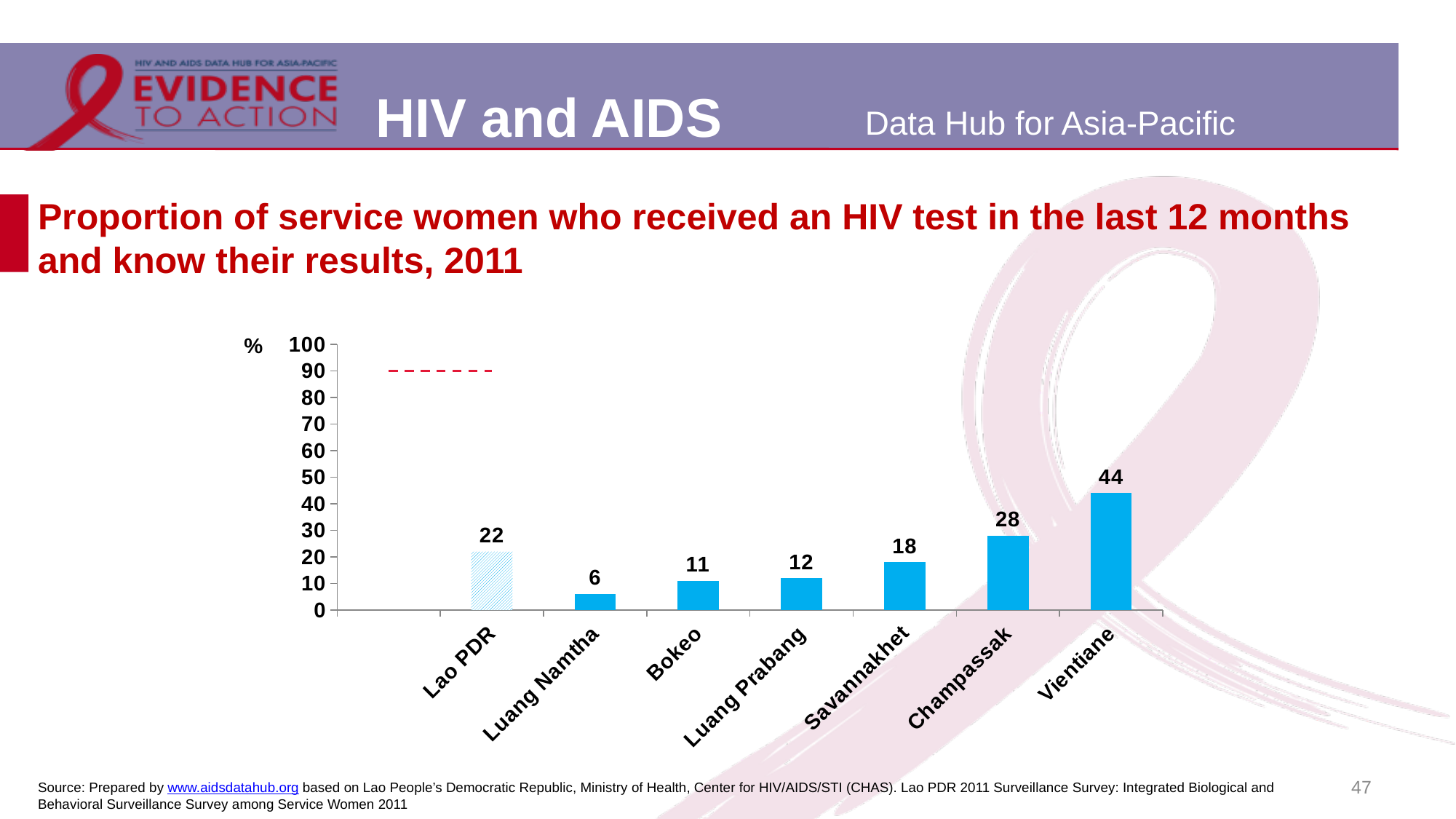
Is the value for Champassak greater or less than 20? greater Which category has the highest value? Vientiane What is the value for Luang Namtha? 6 What is the difference between the values for Vientiane and Champassak? 16 What is the value for Savannakhet? 18 Which category has the lowest value? Luang Namtha What is the value for Vientiane? 44 What kind of chart is shown on the slide? bar chart How many categories are shown on the x axis? 7 What is the value for Lao PDR? 22 What is the maximum value shown on the y axis? 100 Which is larger, the value for Bokeo or the value for Luang Prabang? Luang Prabang